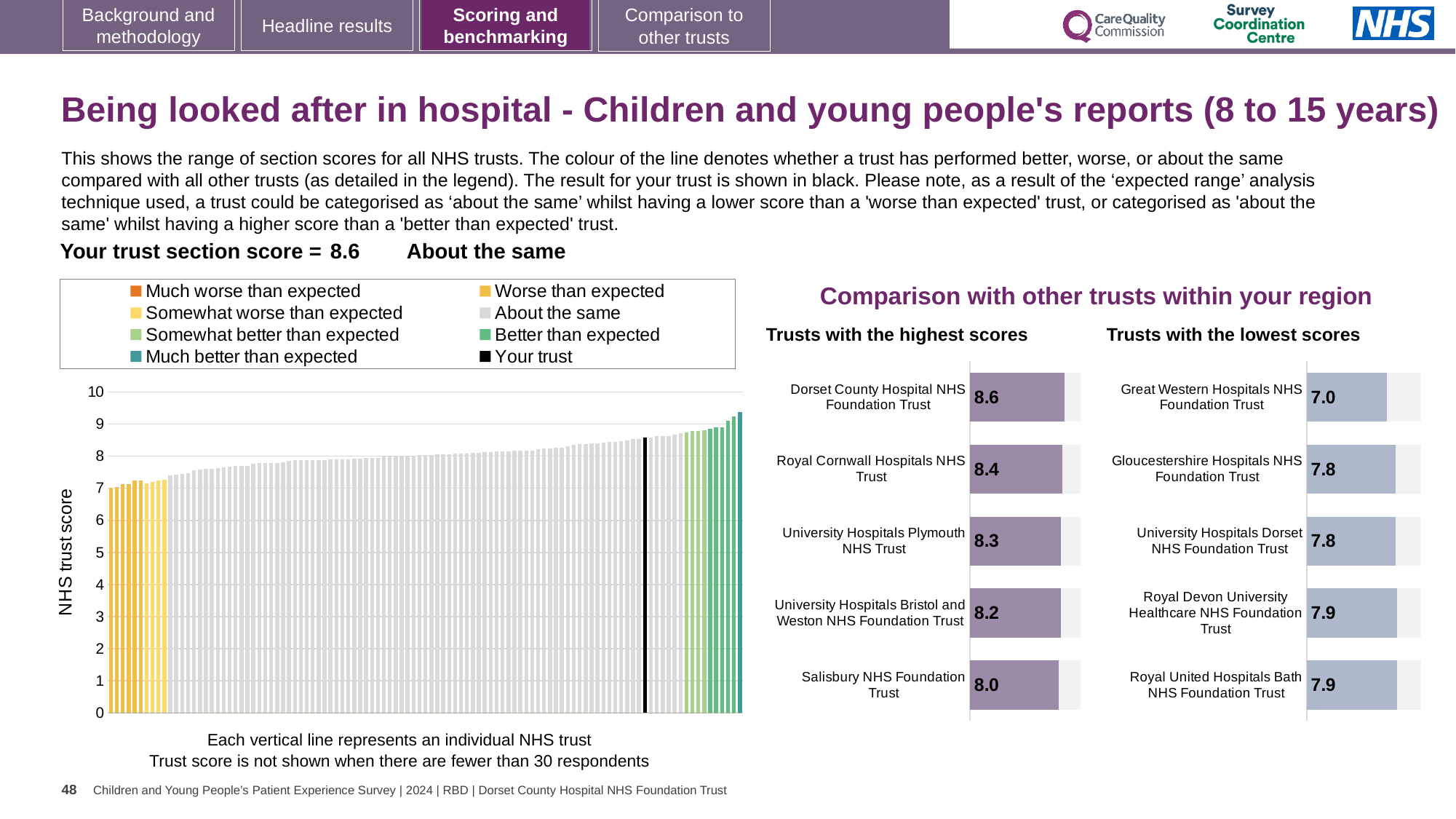
In the 'Trusts with the lowest scores' chart, what is the difference between the scores of Gloucestershire Hospitals NHS Foundation Trust and Great Western Hospitals NHS Foundation Trust? 0.8 In the 'Trusts with the lowest scores' chart, how many trusts are listed? 5 In the main chart on the left showing all NHS trusts, what kind of chart is it? Bar chart In the 'Trusts with the lowest scores' chart, what is the score for Great Western Hospitals NHS Foundation Trust? 7.0 In the main chart on the left showing all NHS trusts, is the value for the black bar (your trust) greater or less than 8? greater In the 'Trusts with the highest scores' chart, what is the score for Royal Cornwall Hospitals NHS Trust? 8.4 In the 'Trusts with the highest scores' chart, which has the larger score: University Hospitals Plymouth NHS Trust or Salisbury NHS Foundation Trust? University Hospitals Plymouth NHS Trust In the 'Trusts with the highest scores' chart, which trust has the highest score? Dorset County Hospital NHS Foundation Trust In the main chart on the left showing all NHS trusts, what is the label on the vertical axis? NHS trust score In the 'Trusts with the lowest scores' chart, which trust has the lowest score? Great Western Hospitals NHS Foundation Trust In the 'Trusts with the highest scores' chart, what is the difference between the scores of Dorset County Hospital NHS Foundation Trust and Salisbury NHS Foundation Trust? 0.6 In the 'Trusts with the highest scores' chart, which trust has the lowest score? Salisbury NHS Foundation Trust